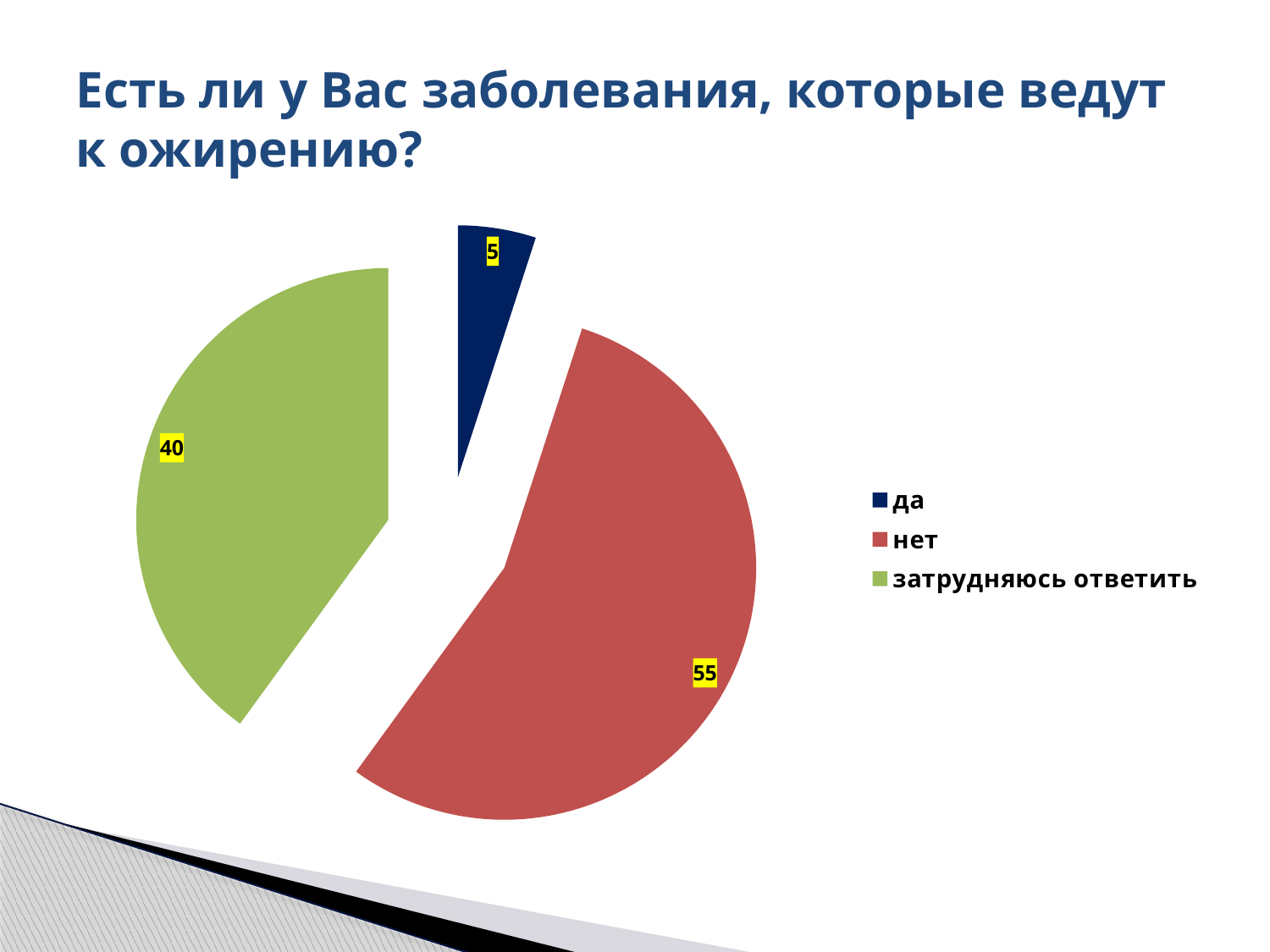
What kind of chart is shown on the slide? pie chart What is the difference between the values for "нет" and "затрудняюсь ответить"? 15 What value is shown for the "да" slice? 5 How many slices does the pie chart have? 3 What is the title of the chart on the slide? Есть ли у Вас заболевания, которые ведут к ожирению? Which is larger, the value for "да" or the value for "затрудняюсь ответить"? затрудняюсь ответить What share of the pie does the "нет" slice represent? 55% What value is shown for the "затрудняюсь ответить" slice? 40 Which category has the largest slice of the pie? нет What is the difference between the values for "затрудняюсь ответить" and "да"? 35 What value is shown for the "нет" slice? 55 Which category has the smallest slice of the pie? да